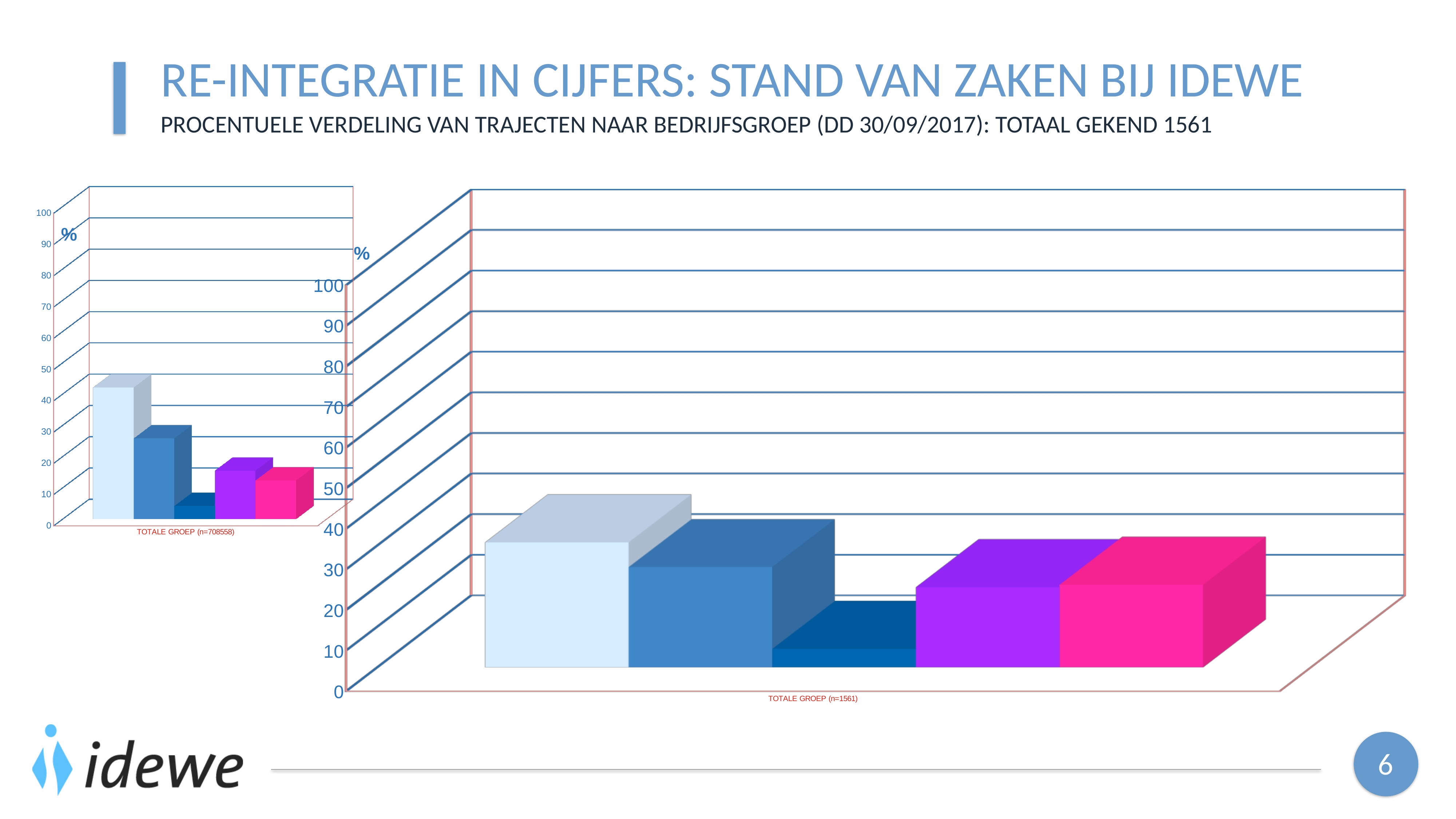
In the large chart on the right, which is larger: the light blue bar or the medium blue bar? the light blue bar What unit label is shown on the vertical axis of the charts? % What is the category label on the x axis of the large chart on the right? TOTALE GROEP (n=1561) How many categories are shown on the x axis of the large chart on the right? 1 In the large chart on the right, which coloured bar is the shortest? the dark blue bar In the small chart on the left, is the value of the light blue bar greater or less than 30? greater In the large chart on the right, is the value of the light blue bar greater or less than 20? greater What is the category label on the x axis of the small chart on the left? TOTALE GROEP (n=708558) What kind of chart is the large chart on the right of the slide? bar chart In the large chart on the right, which coloured bar is the tallest? the light blue bar How many bars are plotted in the large chart on the right? 5 In the small chart on the left, is the value of the dark blue bar greater or less than 20? less